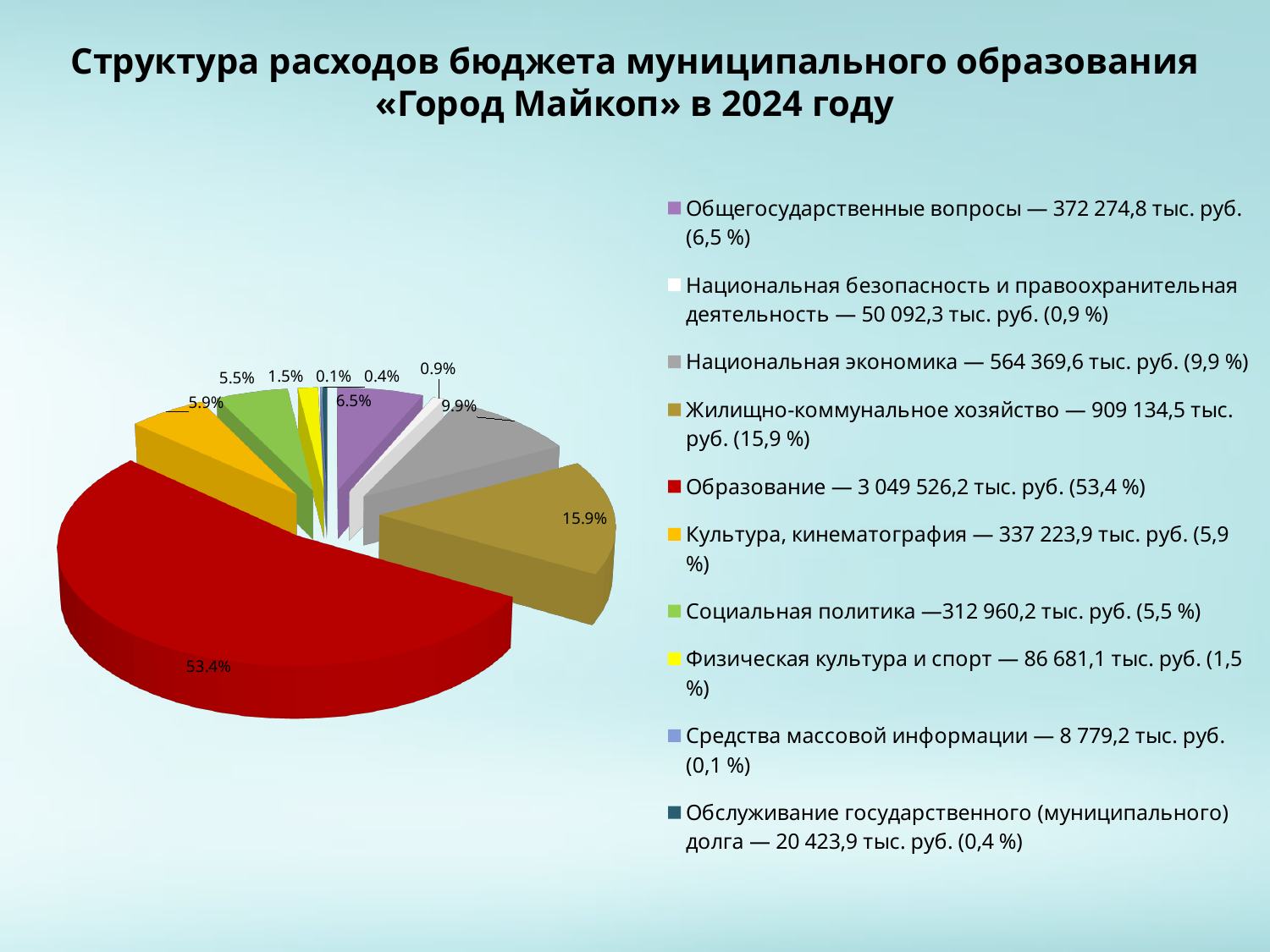
Which category has the largest share of the budget expenditures? Образование What colour is the slice for Образование? Red According to the legend, what is the amount of expenditures on Образование? 3 049 526,2 тыс. руб. By how many percentage points does the share of Образование exceed the share of Жилищно-коммунальное хозяйство? 37.5% What percentage is shown for Национальная экономика? 9.9% What share of expenditures goes to Жилищно-коммунальное хозяйство? 15.9% Which has a larger share: Культура, кинематография or Социальная политика? Культура, кинематография What percentage is shown for Физическая культура и спорт? 1.5% What kind of chart is shown on the slide? Pie chart Which category has the smallest share of the budget expenditures? Средства массовой информации How many slices does the pie chart have? 10 How many entries does the legend list? 10